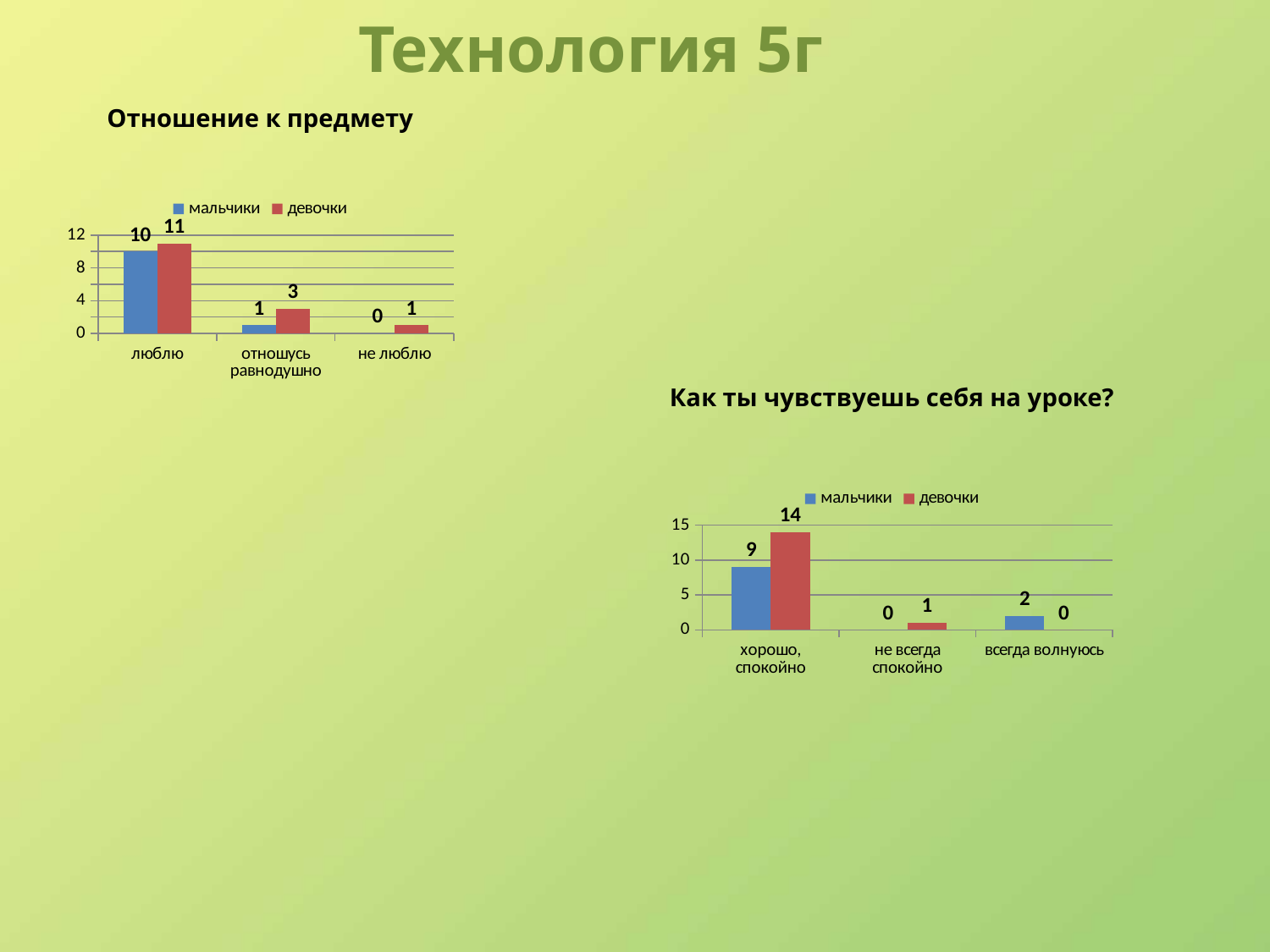
In the 'Как ты чувствуешь себя на уроке?' chart, what is the value for девочки in the 'хорошо, спокойно' category? 14 In the 'Как ты чувствуешь себя на уроке?' chart, which is larger in the 'хорошо, спокойно' category: мальчики or девочки? девочки In the 'Отношение к предмету' chart, what is the value for мальчики in the 'отношусь равнодушно' category? 1 In the 'Как ты чувствуешь себя на уроке?' chart, what is the difference between девочки and мальчики in the 'хорошо, спокойно' category? 5 In the 'Отношение к предмету' chart, how many categories are shown on the x axis? 3 In the 'Как ты чувствуешь себя на уроке?' chart, which category has the lowest value for девочки? всегда волнуюсь What type of chart is the 'Как ты чувствуешь себя на уроке?' chart? bar chart In the 'Отношение к предмету' chart, what is the difference between девочки and мальчики in the 'отношусь равнодушно' category? 2 In the 'Как ты чувствуешь себя на уроке?' chart, what is the value for мальчики in the 'всегда волнуюсь' category? 2 In the 'Отношение к предмету' chart, which category has the highest value for мальчики? люблю In the 'Отношение к предмету' chart, what is the value for девочки in the 'люблю' category? 11 In the 'Отношение к предмету' chart, how many series does the legend list? 2